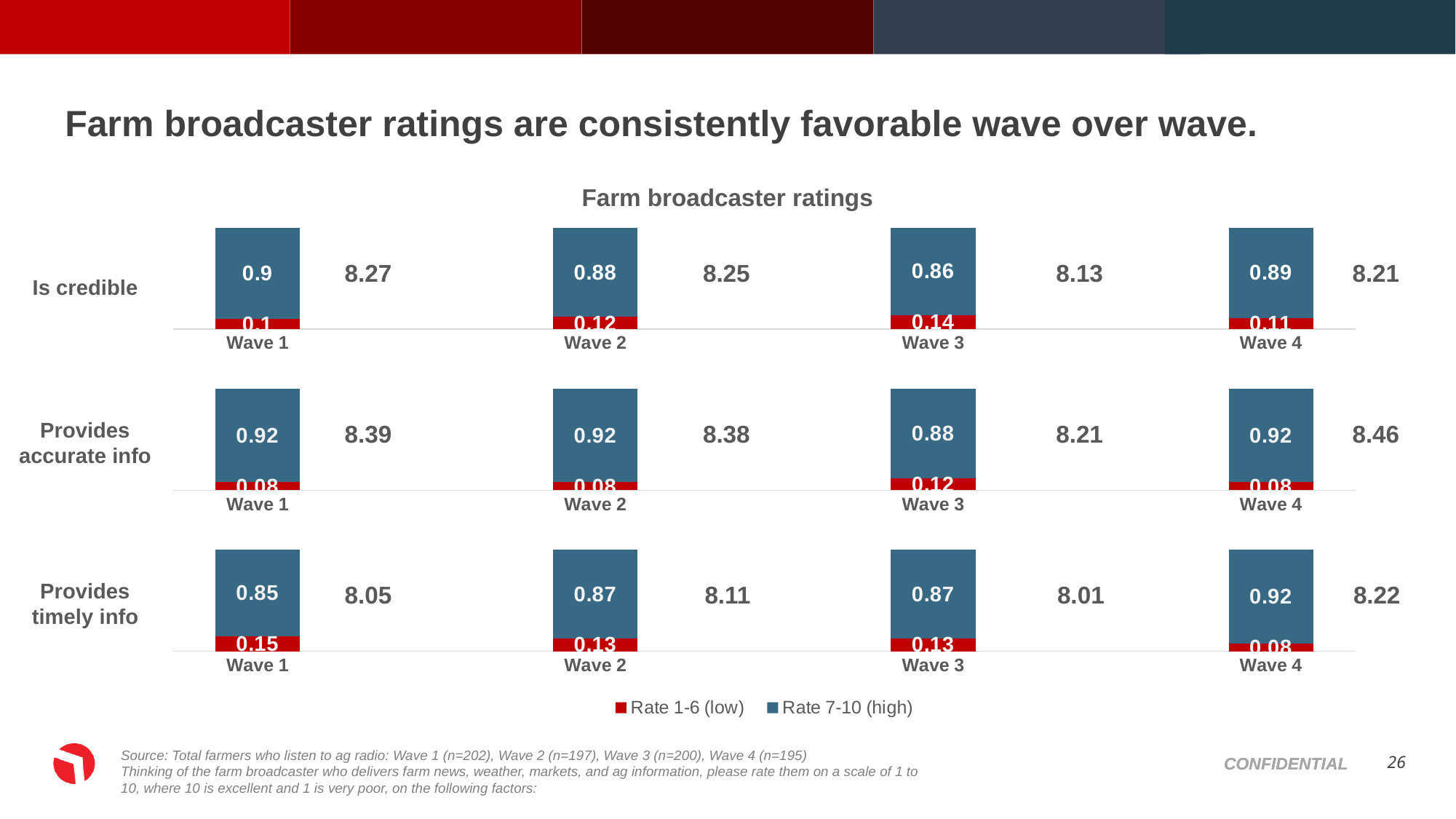
In the 'Is credible' chart, which wave has the lowest Rate 7-10 (high) value? Wave 3 What colour represents the Rate 1-6 (low) series in the legend? Red In the 'Provides timely info' chart, which wave has the highest Rate 7-10 (high) value? Wave 4 What type of chart is used to show the farm broadcaster ratings? Stacked bar chart In the 'Is credible' chart, is the Rate 1-6 (low) value larger for Wave 2 or Wave 3? Wave 3 How many series does the legend list? 2 In the 'Is credible' chart, what is the Rate 1-6 (low) value for Wave 3? 0.14 In the 'Provides timely info' chart, what is the Rate 1-6 (low) value for Wave 1? 0.15 In the 'Provides timely info' chart, what is the difference between the Rate 7-10 (high) values for Wave 4 and Wave 1? 0.07 In the 'Is credible' chart, what is the Rate 7-10 (high) value for Wave 1? 0.9 How many waves are shown in each chart on the slide? 4 In the 'Provides accurate info' chart, what is the Rate 7-10 (high) value for Wave 3? 0.88